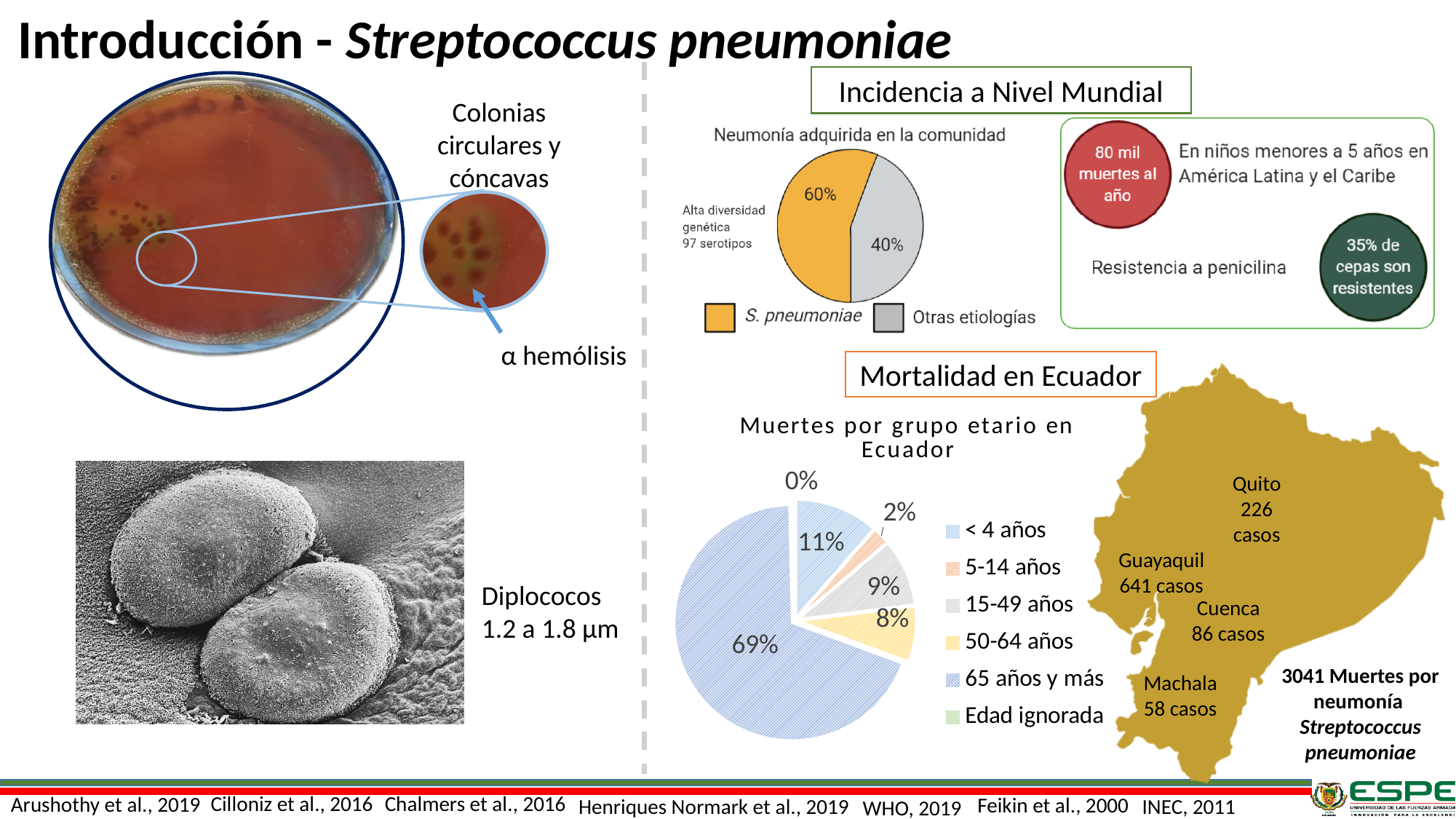
In the 'Neumonía adquirida en la comunidad' chart, which colour represents S. pneumoniae? Orange In the 'Muertes por grupo etario en Ecuador' chart, which age group has the largest share? 65 años y más In the 'Neumonía adquirida en la comunidad' chart, what share is attributed to S. pneumoniae? 60% In the 'Muertes por grupo etario en Ecuador' chart, what share of deaths is for '15-49 años'? 9% In the 'Muertes por grupo etario en Ecuador' chart, what is the difference between the shares for '65 años y más' and '< 4 años'? 58% In the 'Muertes por grupo etario en Ecuador' chart, how many categories does the legend list? 6 In the 'Muertes por grupo etario en Ecuador' chart, what share of deaths is for '50-64 años'? 8% In the 'Neumonía adquirida en la comunidad' chart, what share is attributed to 'Otras etiologías'? 40% What kind of chart is 'Muertes por grupo etario en Ecuador'? Pie chart In the 'Muertes por grupo etario en Ecuador' chart, which is larger, the share for '15-49 años' or for '5-14 años'? 15-49 años In the 'Muertes por grupo etario en Ecuador' chart, what share of deaths is for '65 años y más'? 69% In the 'Muertes por grupo etario en Ecuador' chart, what share of deaths is for '< 4 años'? 11%